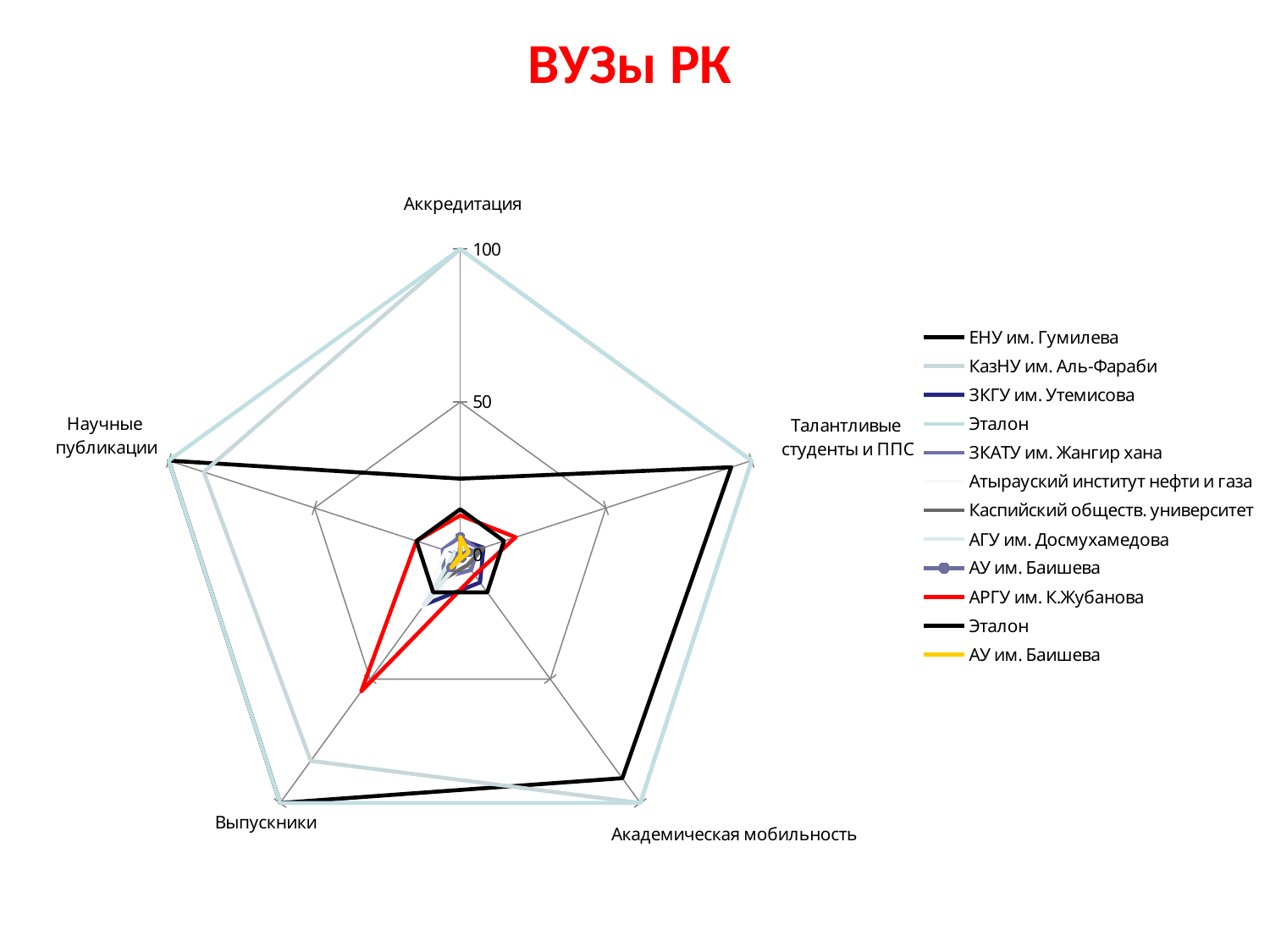
What is the title of the chart? ВУЗы РК For АРГУ им. К.Жубанова, which category has the highest value? Выпускники Is the value for Талантливые студенты и ППС for АРГУ им. К.Жубанова greater or less than 50? less How many axes (categories) does the radar chart have? 5 How many series does the legend list? 12 Which category is at the top of the radar chart? Аккредитация For АРГУ им. К.Жубанова, which category has the higher value: Выпускники or Аккредитация? Выпускники What kind of chart is shown on the slide? radar chart Is the value for Аккредитация for АРГУ им. К.Жубанова greater or less than 50? less What is the maximum value shown on the radar chart's axis scale? 100 Is the value for Академическая мобильность for АРГУ им. К.Жубанова greater or less than 50? less